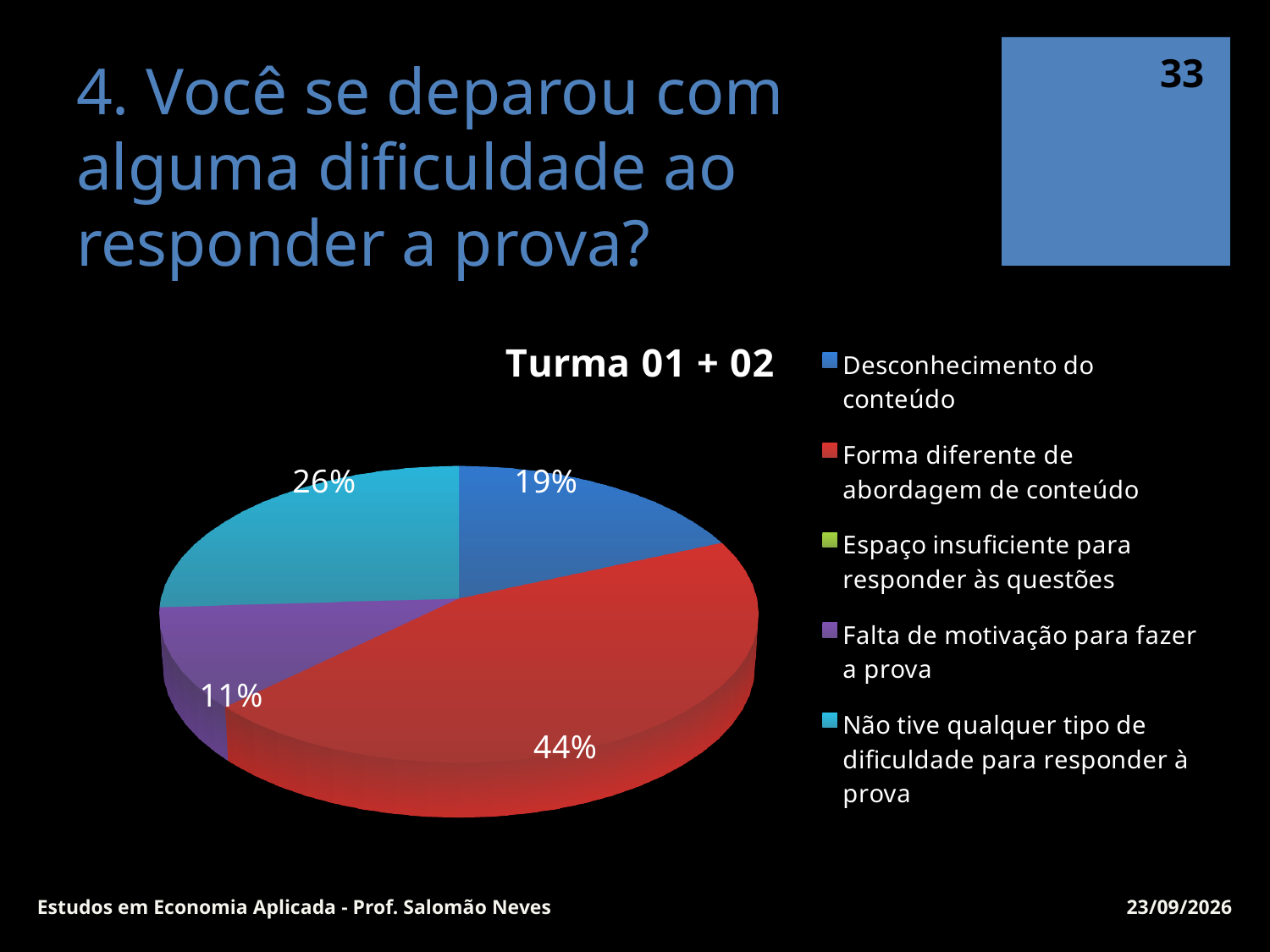
What percentage of the pie corresponds to "Desconhecimento do conteúdo"? 19% What percentage of the pie corresponds to "Falta de motivação para fazer a prova"? 11% What percentage of the pie corresponds to "Forma diferente de abordagem de conteúdo"? 44% How many entries does the legend list? 5 Which of the labelled slices has the smallest share of the pie? Falta de motivação para fazer a prova What type of chart is shown on the slide? pie chart Which is larger: the share for "Não tive qualquer tipo de dificuldade para responder à prova" or the share for "Desconhecimento do conteúdo"? Não tive qualquer tipo de dificuldade para responder à prova What colour is the slice for "Forma diferente de abordagem de conteúdo"? red What is the difference in percentage points between "Forma diferente de abordagem de conteúdo" and "Desconhecimento do conteúdo"? 25 Which category has the largest share of the pie? Forma diferente de abordagem de conteúdo What is the title of the chart? Turma 01 + 02 What percentage of the pie corresponds to "Não tive qualquer tipo de dificuldade para responder à prova"? 26%